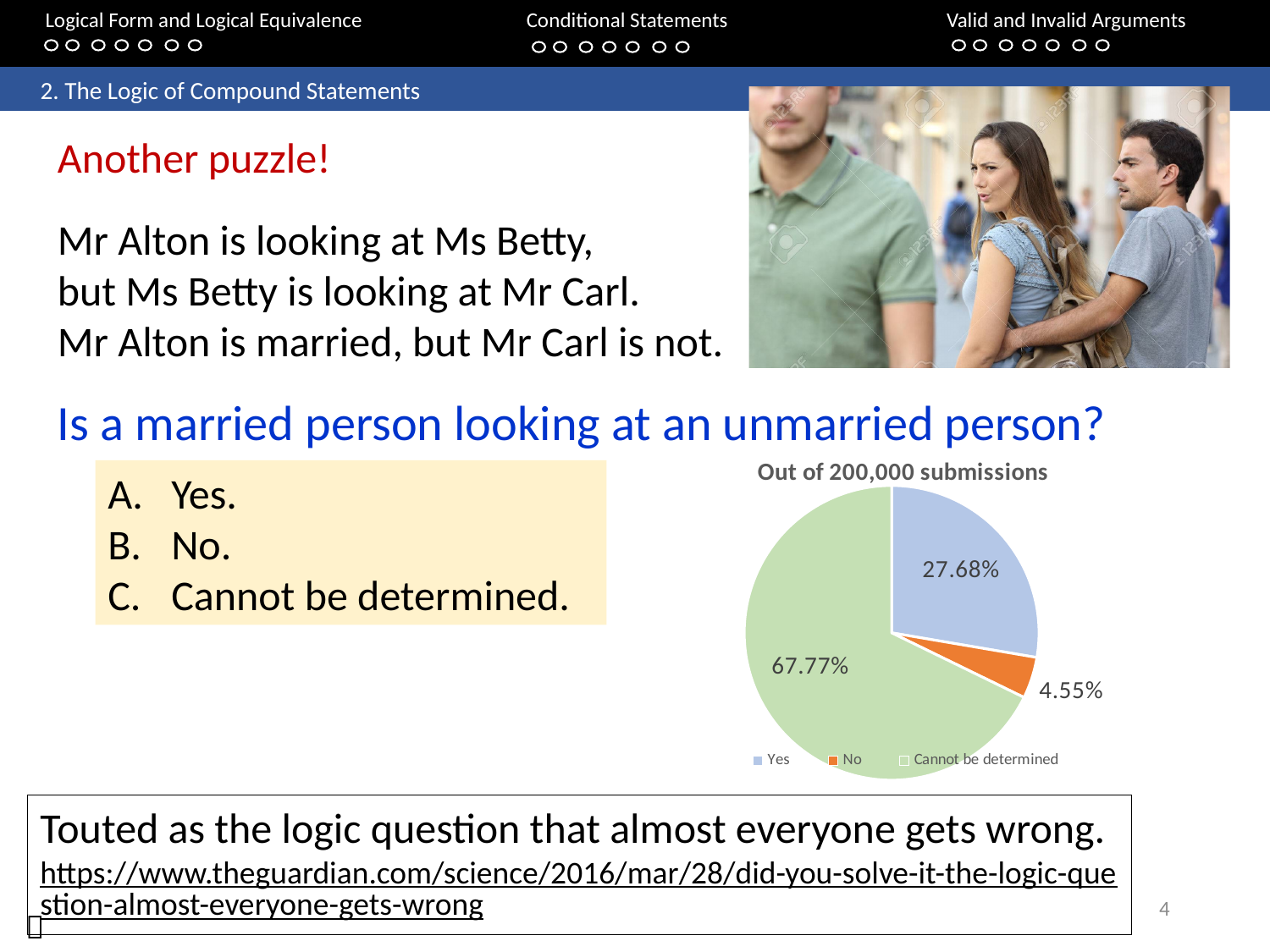
What type of chart is shown on the slide? pie chart What is the difference in percentage points between the "Yes" share and the "No" share? 23.13 What is the title of the pie chart? Out of 200,000 submissions What percentage of submissions answered "Cannot be determined"? 67.77% Which answer received the largest share of submissions? Cannot be determined How many entries does the legend of the pie chart list? 3 What percentage of submissions answered "Yes"? 27.68% What percentage of submissions answered "No"? 4.55% Which received a larger share of submissions, "Yes" or "No"? Yes What is the difference in percentage points between the "Cannot be determined" share and the "Yes" share? 40.09 Which answer received the smallest share of submissions? No How many slices does the pie chart have? 3